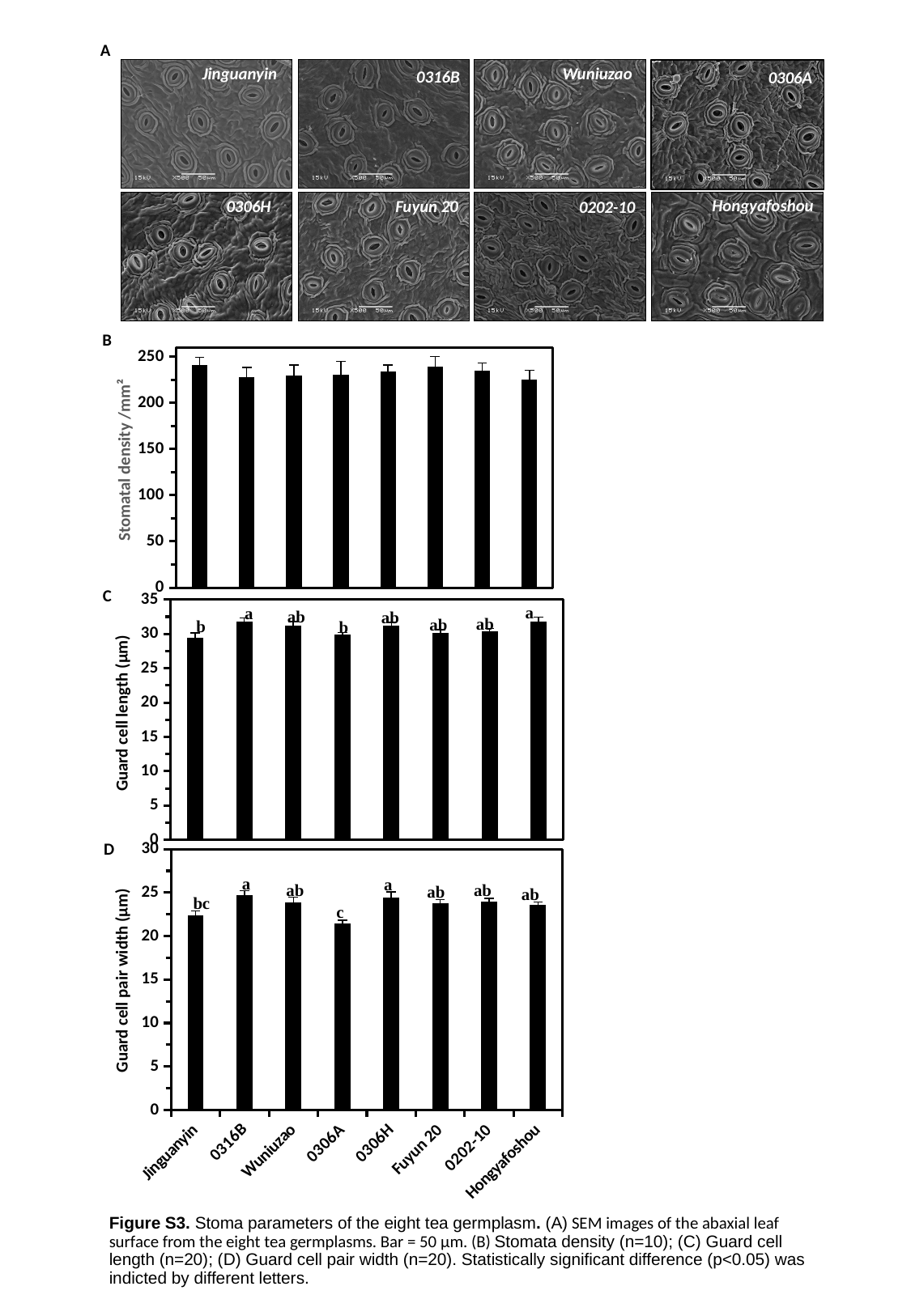
In chart D (Guard cell pair width), is the value for 0316B greater or less than 20? greater In chart D (Guard cell pair width), what significance letter is printed above the bar for 0306A? c How many tea germplasms (categories) are plotted in chart D (Guard cell pair width)? 8 In chart C (Guard cell length), is the value for Jinguanyin greater or less than 30? less In chart B (Stomatal density), is the value for Hongyafoshou greater or less than 200? greater In chart D (Guard cell pair width), which germplasm has the lowest value? 0306A What kind of chart is chart B (Stomatal density)? bar chart What is the y-axis title of chart B? Stomatal density /mm² In chart D (Guard cell pair width), which is larger, the value for 0316B or the value for 0306A? 0316B